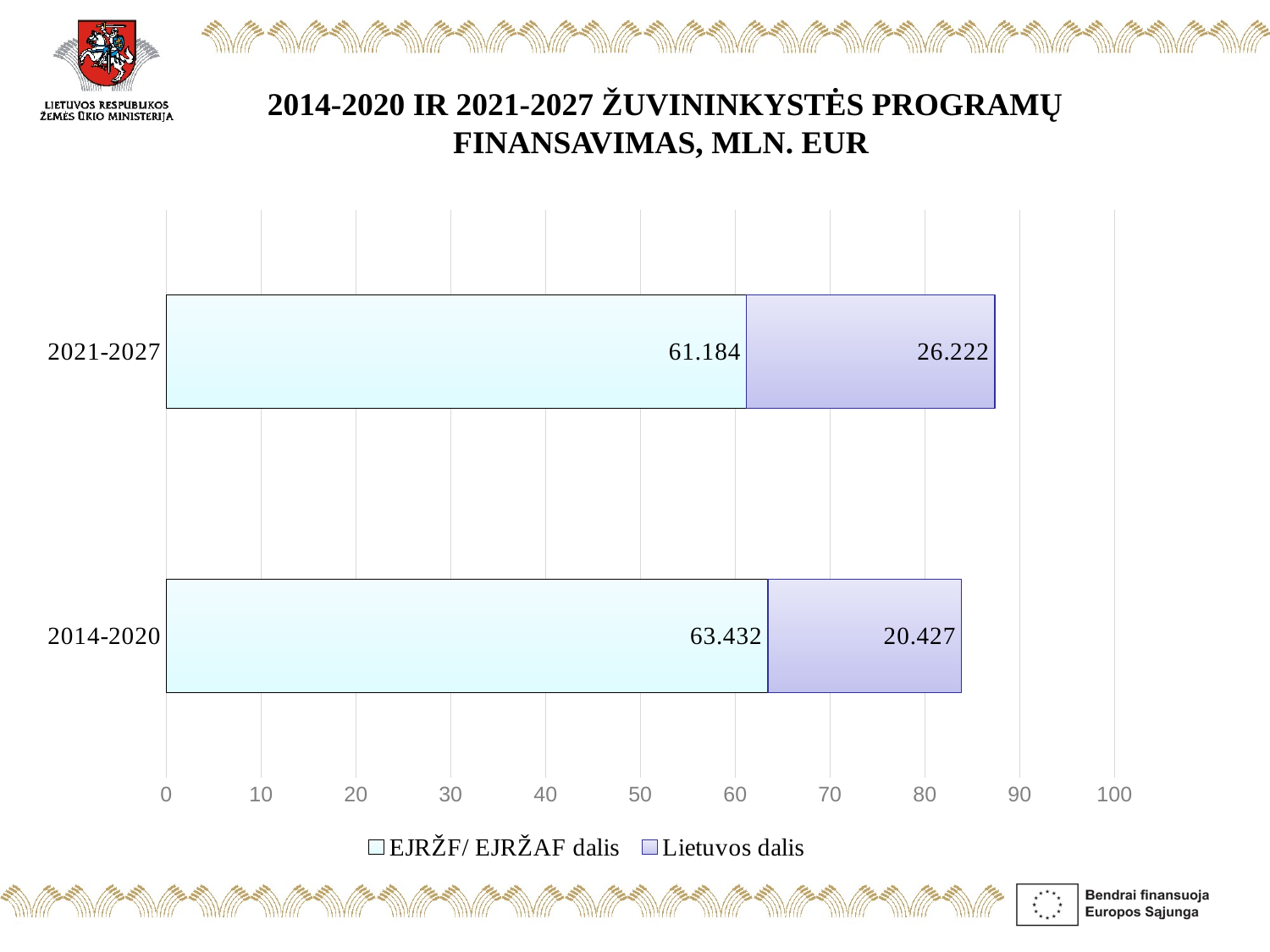
What is the value of EJRŽF/ EJRŽAF dalis for 2021-2027? 61.184 What is the value of EJRŽF/ EJRŽAF dalis for 2014-2020? 63.432 Which period has the higher Lietuvos dalis value? 2021-2027 What is the value of Lietuvos dalis for 2014-2020? 20.427 How many series does the legend list? 2 What kind of chart is shown on the slide? Stacked bar chart What is the total of the stacked bar for 2021-2027? 87.406 What is the difference between the Lietuvos dalis values for 2021-2027 and 2014-2020? 5.795 Is the EJRŽF/ EJRŽAF dalis value larger for 2014-2020 or for 2021-2027? 2014-2020 What is the total of the stacked bar for 2014-2020? 83.859 Which period has the lower EJRŽF/ EJRŽAF dalis value? 2021-2027 What is the value of Lietuvos dalis for 2021-2027? 26.222